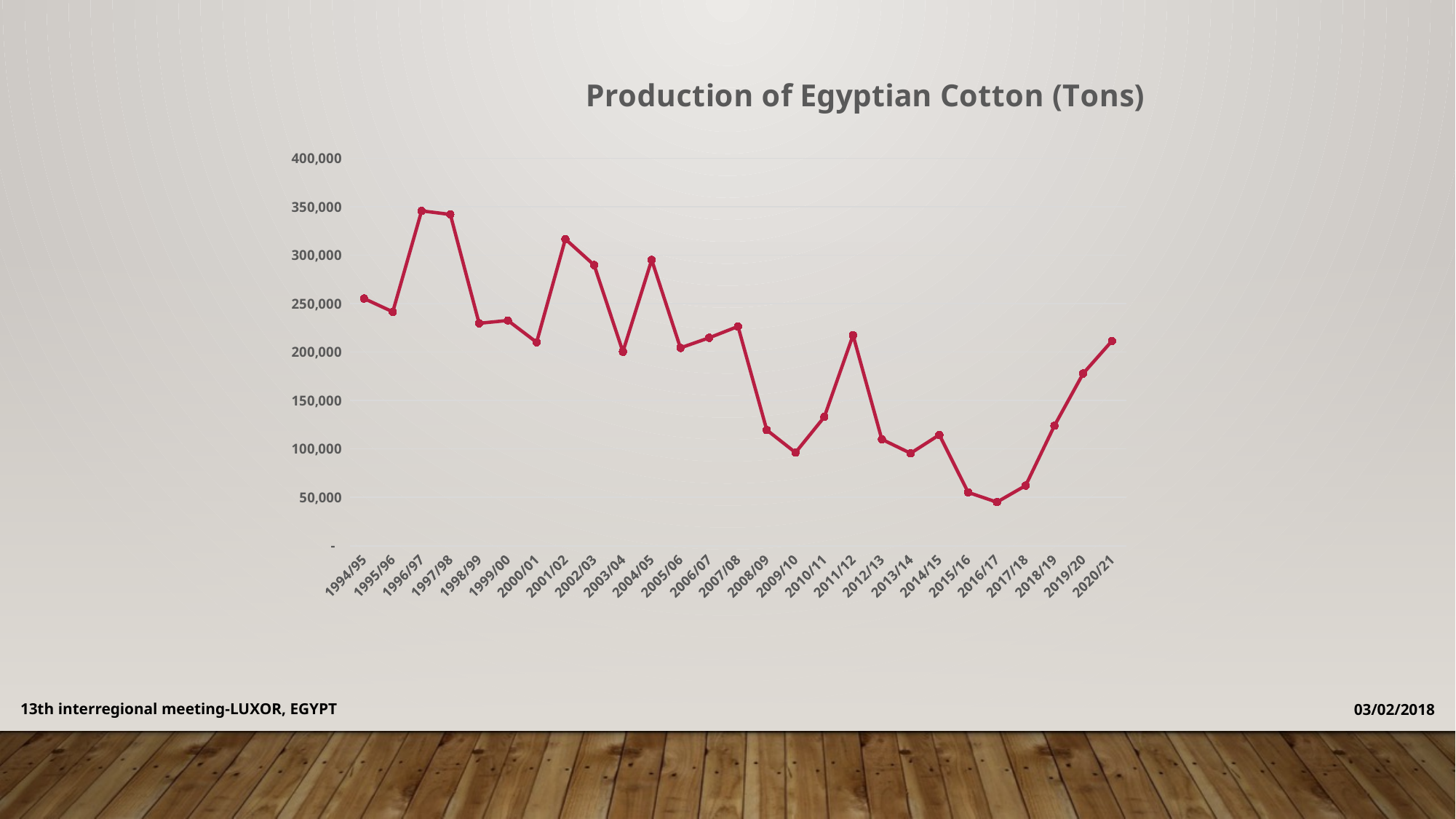
Which season has the lowest production? 2016/17 How many seasons are plotted along the x axis? 27 Does production rise or fall from 2007/08 to 2009/10? fall Is the production for 1996/97 greater or less than 300,000? greater Which season has higher production, 2001/02 or 2002/03? 2001/02 Which season has higher production, 2011/12 or 2012/13? 2011/12 Is the production for 2015/16 greater or less than 100,000? less Is the production for 2004/05 greater or less than 250,000? greater What kind of chart is shown on the slide? line chart Does production rise or fall from 2016/17 to 2020/21? rise What is the title of the chart? Production of Egyptian Cotton (Tons)